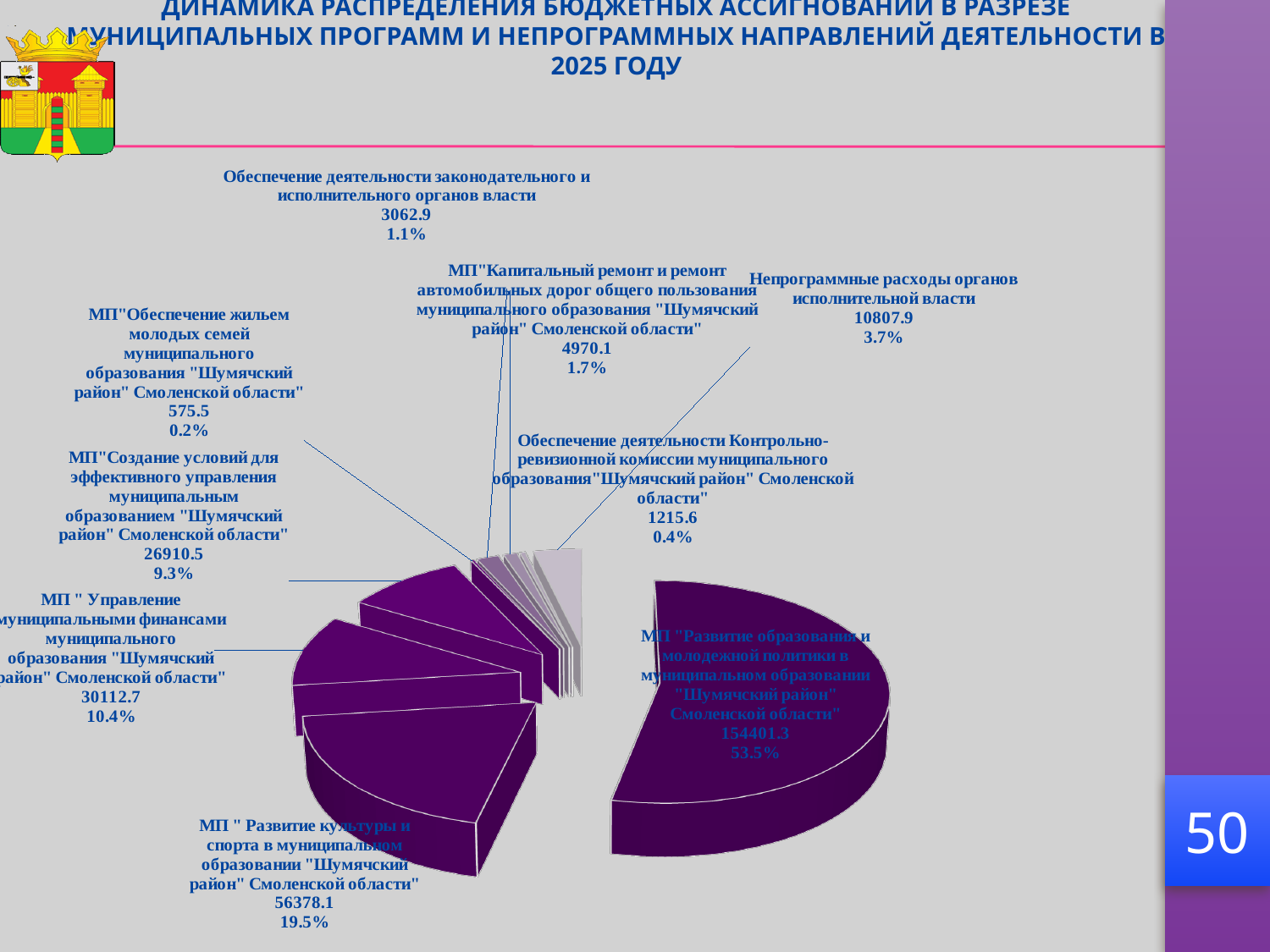
How many categories (slices) does the pie chart show? 9 Which category has the largest slice of the pie? МП "Развитие образования и молодежной политики в муниципальном образовании "Шумячский район" Смоленской области" What is the difference between the values for МП "Управление муниципальными финансами..." (30112.7) and МП "Создание условий для эффективного управления муниципальным образованием..." (26910.5)? 3202.2 What share of the pie does МП "Развитие культуры и спорта в муниципальном образовании "Шумячский район" Смоленской области" represent? 19.5% What kind of chart is shown on the slide? Pie chart What is the value for Непрограммные расходы органов исполнительной власти? 10807.9 Which is larger: the value for Обеспечение деятельности законодательного и исполнительного органов власти or the value for МП "Капитальный ремонт и ремонт автомобильных дорог..."? МП "Капитальный ремонт и ремонт автомобильных дорог..." What is the value for МП "Развитие образования и молодежной политики в муниципальном образовании "Шумячский район" Смоленской области"? 154401.3 What year does the chart title say the budget allocation distribution refers to? 2025 What is the value for Обеспечение деятельности Контрольно-ревизионной комиссии муниципального образования "Шумячский район" Смоленской области? 1215.6 Which category has the smallest slice of the pie? МП "Обеспечение жильем молодых семей муниципального образования "Шумячский район" Смоленской области" What percentage is shown for МП "Управление муниципальными финансами муниципального образования "Шумячский район" Смоленской области"? 10.4%